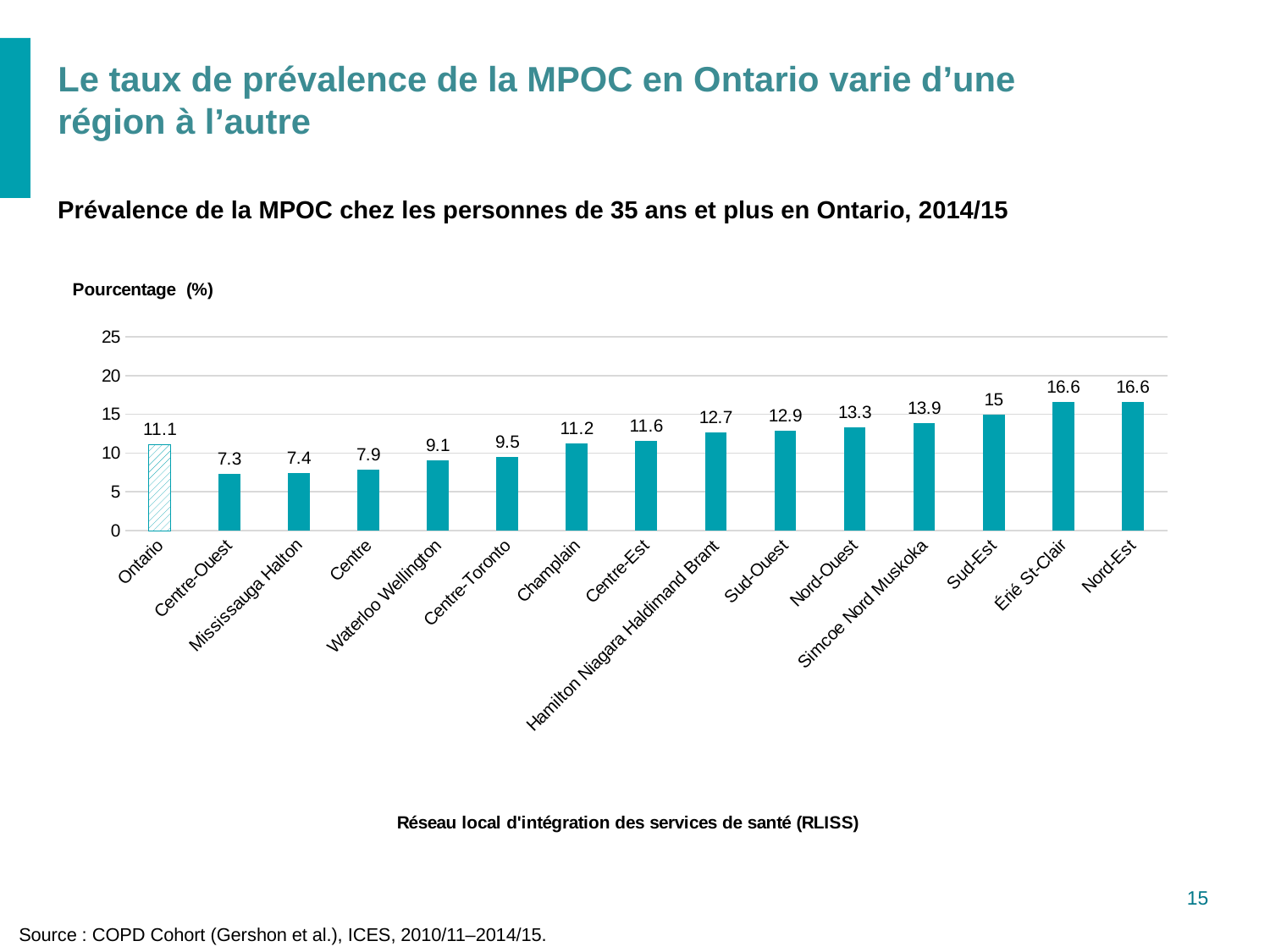
What is the value shown for Hamilton Niagara Haldimand Brant? 12.7 Which has a higher value, Centre-Toronto or Sud-Ouest? Sud-Ouest What is the value shown for Sud-Est? 15 What value is shown for Nord-Est? 16.6 What is the COPD prevalence value shown for Ontario? 11.1 What kind of chart is shown on the slide? Bar chart Is the value for Waterloo Wellington greater or less than 10? less What is the label on the vertical axis of the chart? Pourcentage (%) Excluding the Ontario bar, do the values rise or fall from left to right across the regions? Rise What is the value shown for Champlain? 11.2 What is the difference between the values for Nord-Est and Centre-Ouest? 9.3 How many bars are plotted in the chart? 15